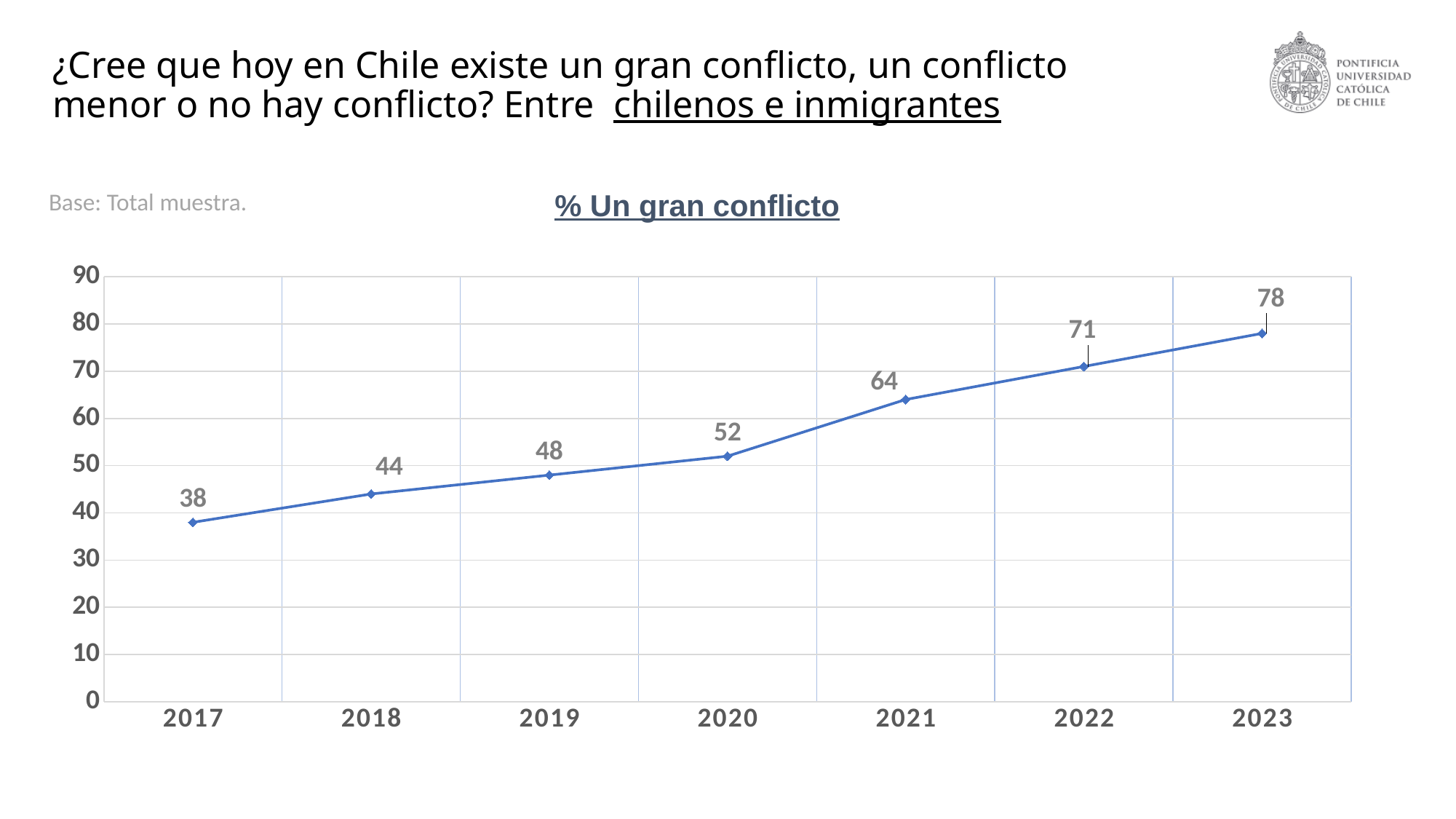
What is the difference between the values for 2021 and 2020? 12 Which is larger, the value for 2019 or the value for 2022? 2022 Which year has the highest value? 2023 What is the difference between the values for 2023 and 2017? 40 How many years are plotted on the chart? 7 Do the values rise or fall from 2017 to 2023? rise What is the value for 2023? 78 Which year has the lowest value? 2017 What kind of chart is shown? line chart What is the value for 2017? 38 Is the value for 2021 greater or less than 60? greater What is the value for 2020? 52